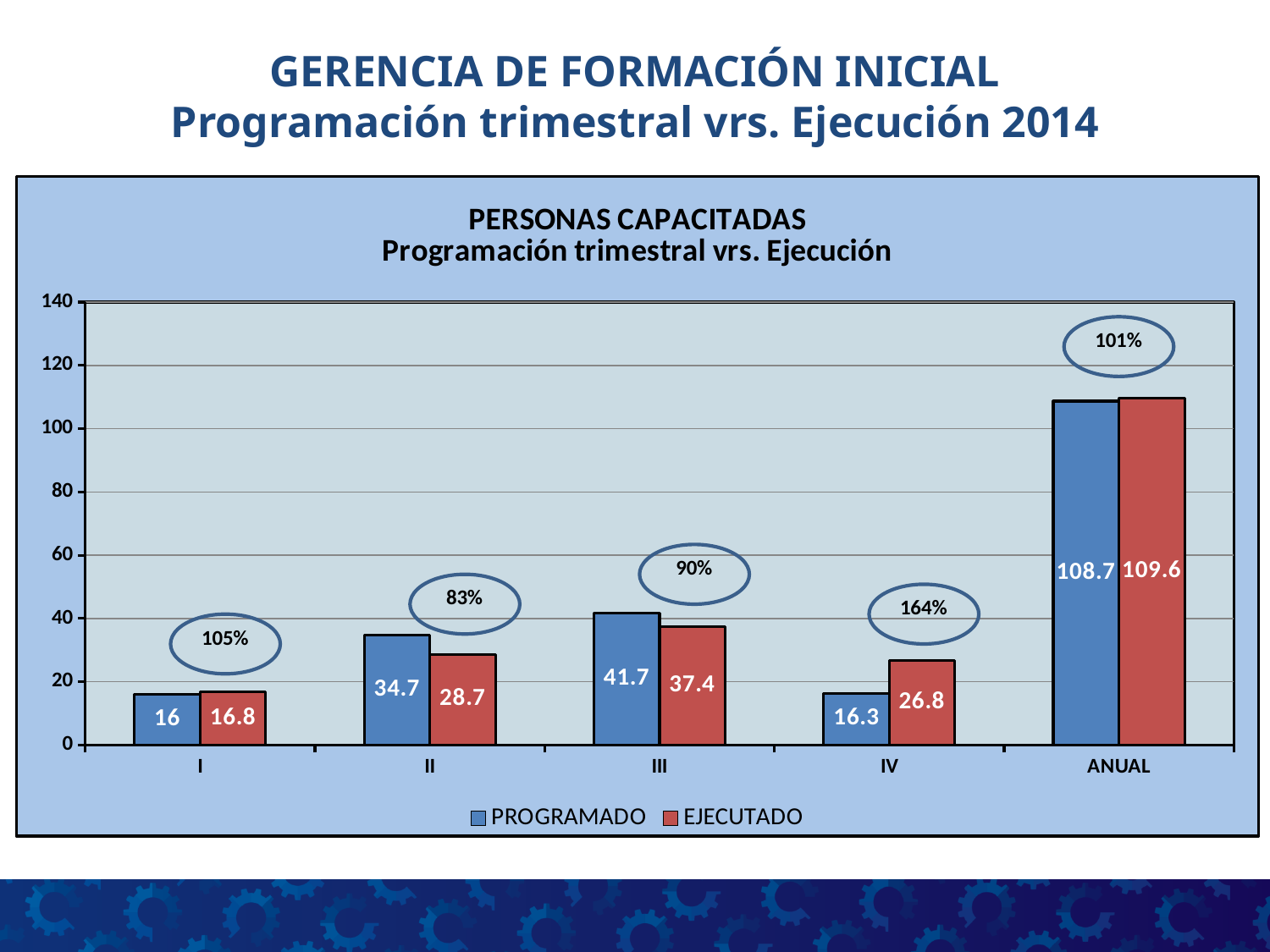
What percentage is shown in the circle above the ANUAL bars? 101% What colour are the EJECUTADO bars? red What kind of chart is shown? bar chart Among the quarters I to IV, which has the lowest EJECUTADO value? I What is the difference between the PROGRAMADO and EJECUTADO values for quarter II? 6 Which category has the highest PROGRAMADO value? ANUAL For quarter IV, which is larger: PROGRAMADO or EJECUTADO? EJECUTADO What is the EJECUTADO value for ANUAL? 109.6 How many series does the legend list? 2 How many categories are shown on the x axis? 5 What is the EJECUTADO value for quarter IV? 26.8 What is the PROGRAMADO value for quarter III? 41.7